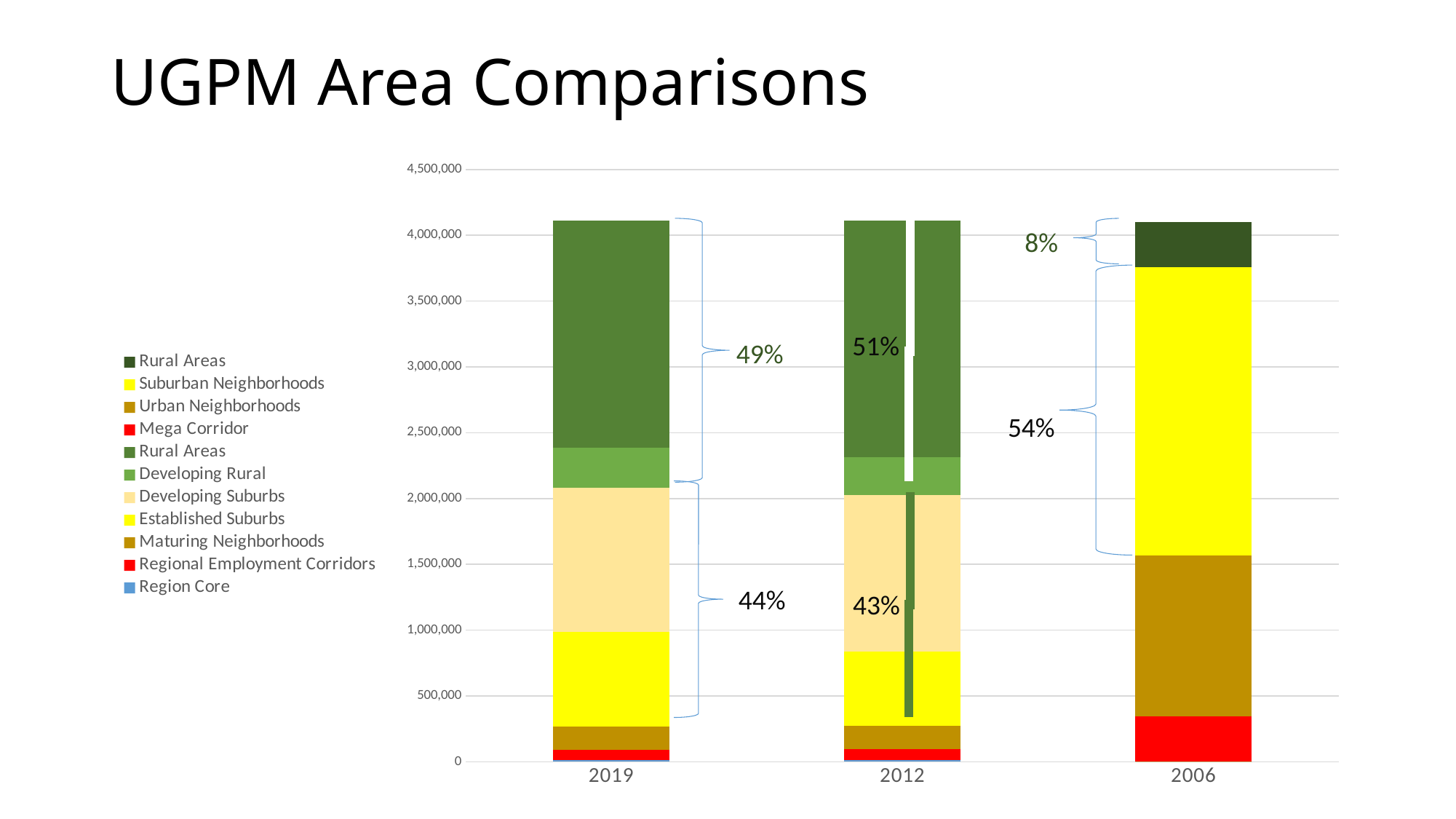
Is the total height of the 2019 bar greater or less than 4,000,000? greater What percentage is annotated for the upper (rural) portion of the 2019 bar? 49% What kind of chart is shown on the slide? stacked bar chart What is the title of the slide? UGPM Area Comparisons What percentage is annotated for the lower portion of the 2012 bar? 43% What percentage is annotated for the Rural Areas segment at the top of the 2006 bar? 8% What percentage is annotated for the Suburban Neighborhoods segment of the 2006 bar? 54% Is the top of the Mega Corridor segment in the 2006 bar greater or less than 500,000? less What percentage is annotated for the lower portion of the 2019 bar? 44% What percentage is annotated for the upper portion of the 2012 bar? 51% How many series does the legend list? 11 How many bars (years) are plotted on the x axis? 3